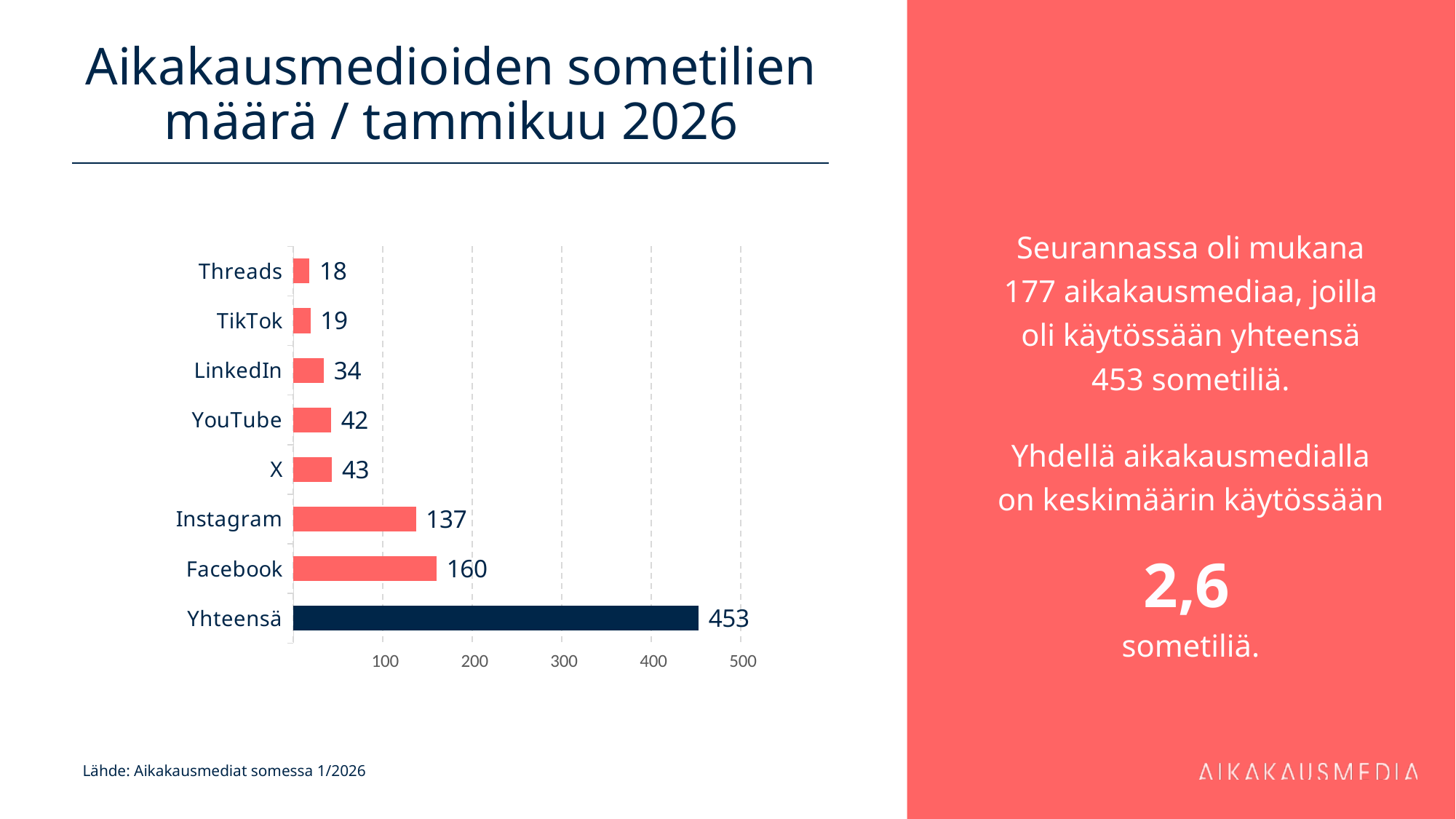
Is the value for Instagram greater or less than 100? greater What is the difference between the values for Facebook and Instagram? 23 What is the value for Facebook? 160 What is the title of the slide? Aikakausmedioiden sometilien määrä / tammikuu 2026 What is the value for LinkedIn? 34 What kind of chart is shown on the slide? bar chart Which is larger, the value for YouTube or the value for LinkedIn? YouTube Excluding the Yhteensä total bar, which platform has the highest value? Facebook Which platform has the lowest value? Threads What is the value shown for Yhteensä? 453 How many bars are shown in the chart? 8 What is the value for Instagram? 137